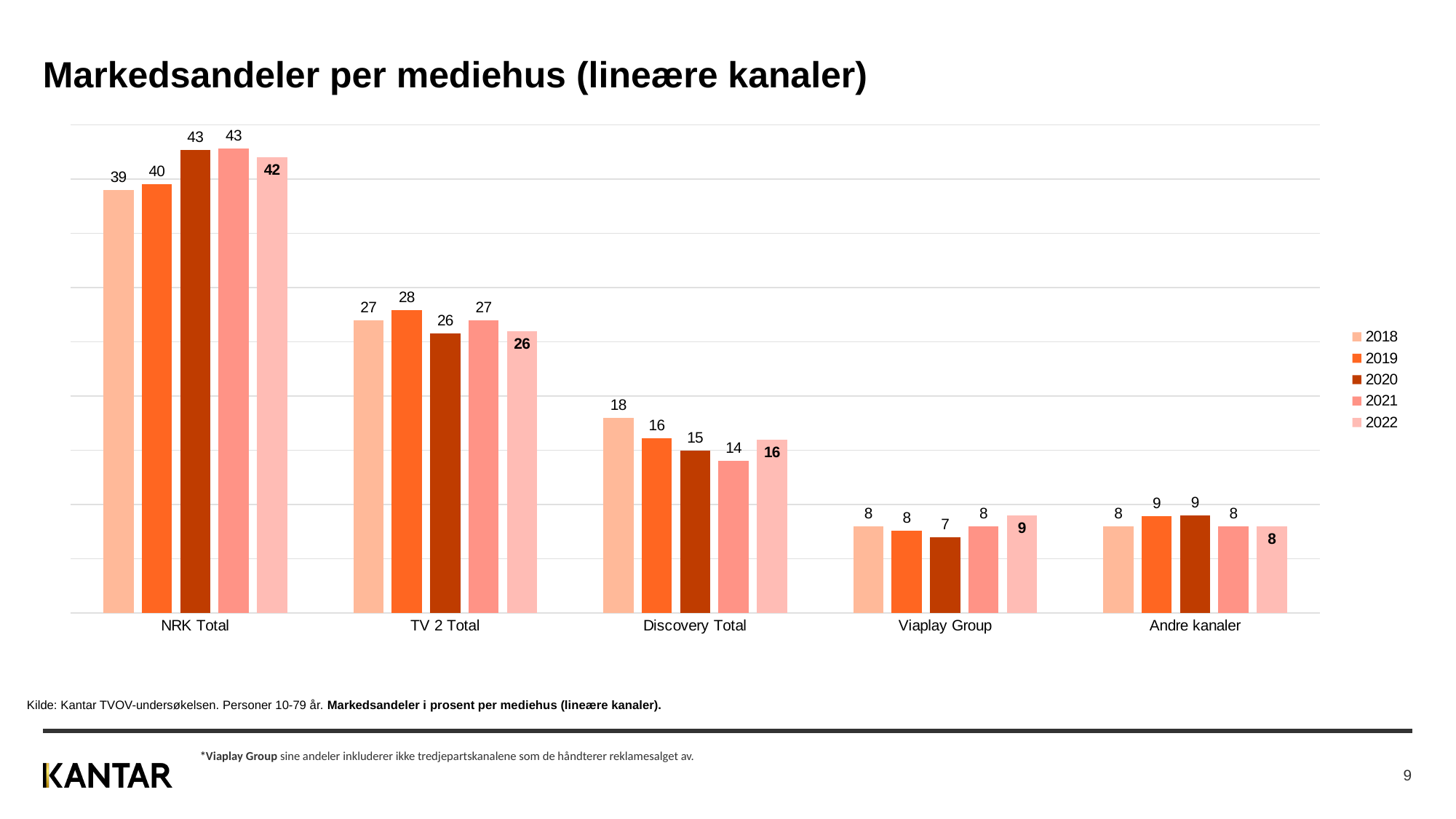
What is the value for Viaplay Group in 2020? 7 How many series does the legend list? 5 What is the value for NRK Total in 2022? 42 How many categories are shown on the x axis? 5 What is the value for Discovery Total in 2021? 14 What is the difference between the NRK Total values for 2018 and 2022? 3 What kind of chart is shown on the slide? Bar chart Which category has the highest value in 2022? NRK Total Which is larger: the 2022 value for TV 2 Total or the 2022 value for Discovery Total? TV 2 Total Which year has the lowest value for Discovery Total? 2021 What is the title of the chart? Markedsandeler per mediehus (lineære kanaler) What is the value for TV 2 Total in 2019? 28